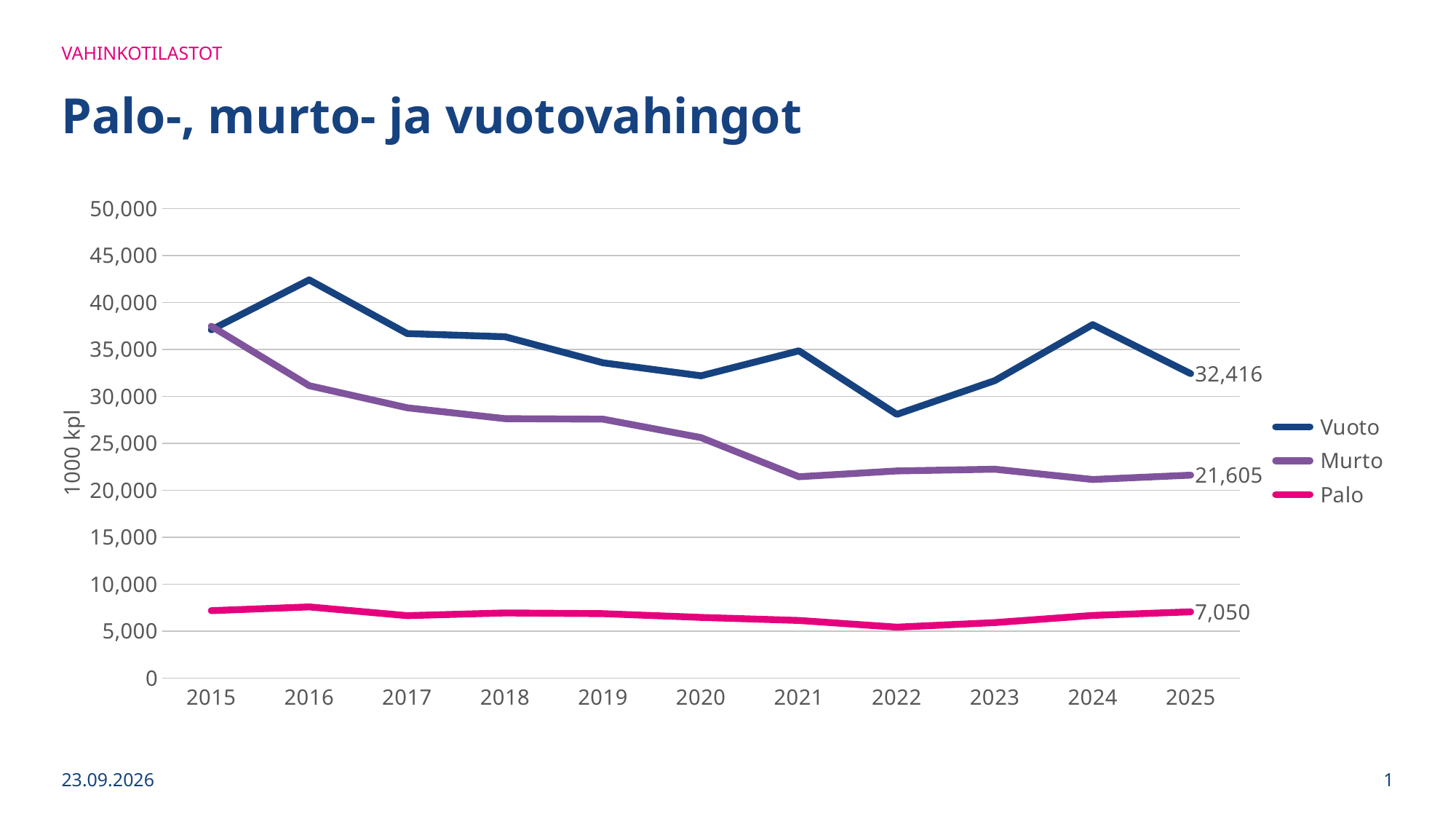
How many series does the legend list? 3 Is the value for Vuoto in 2022 greater or less than 30,000? less What kind of chart is shown on the slide? line chart What is the value for Palo in 2025? 7,050 What is the value for Murto in 2025? 21,605 Is the value for Vuoto in 2016 greater or less than 40,000? greater What is the difference between the Vuoto and Murto values in 2025? 10,811 In which year does the Vuoto series reach its highest value? 2016 What is the value for Vuoto in 2025? 32,416 Which series has the larger value in 2025, Murto or Palo? Murto How many years are shown on the x axis? 11 Is the value for Murto in 2021 greater or less than 25,000? less